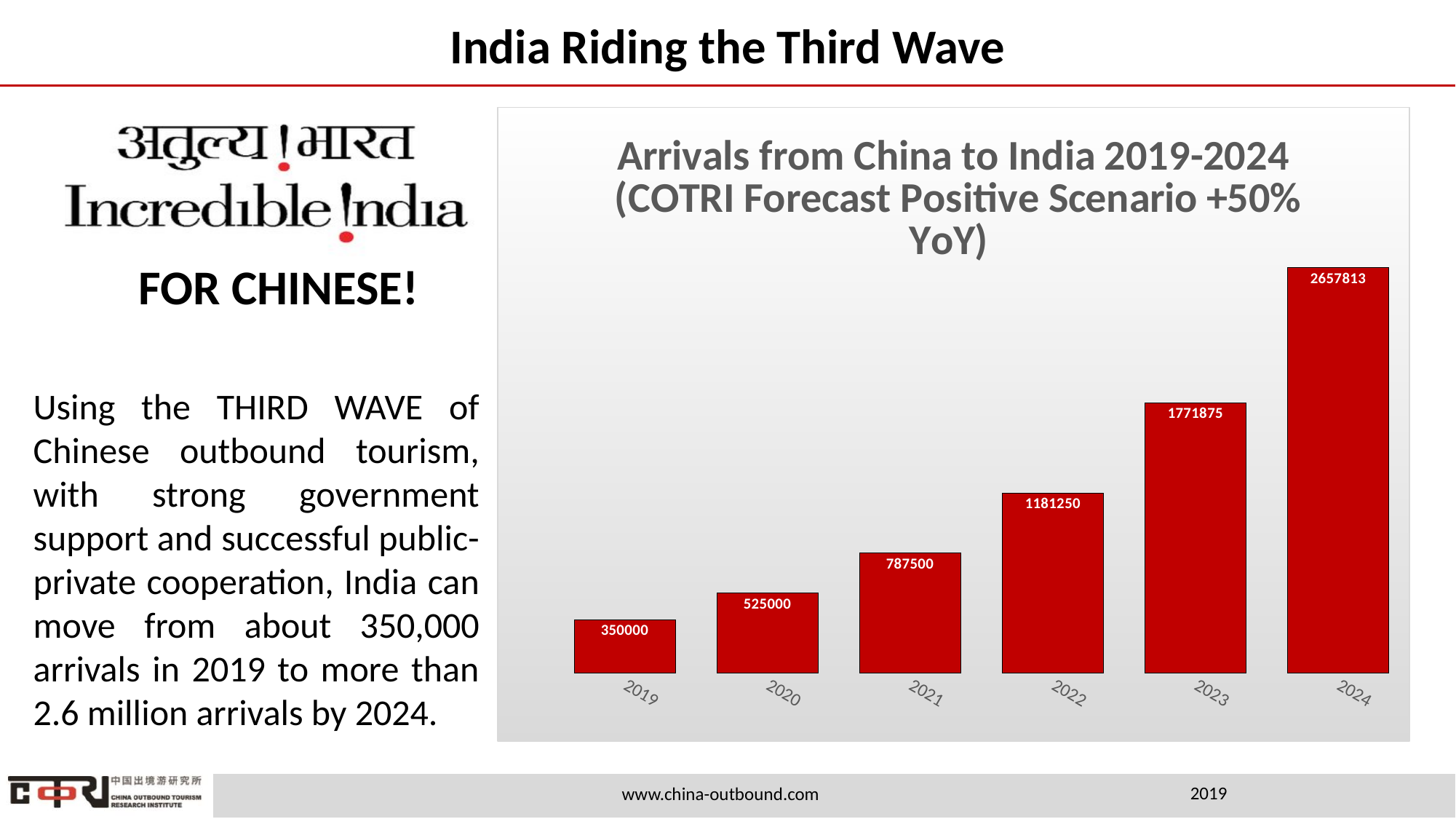
What is the difference between the values for 2020 and 2019? 175000 Which is larger, the value for 2022 or the value for 2021? 2022 Which year has the highest value in the chart? 2024 Do the values rise or fall from 2019 to 2024? Rise Which year has the lowest value in the chart? 2019 What is the difference between the values for 2024 and 2023? 885938 How many years are shown in the chart? 6 What kind of chart is shown on the slide? Bar chart What is the value for 2023 in the chart? 1771875 What is the title of the chart? Arrivals from China to India 2019-2024 (COTRI Forecast Positive Scenario +50% YoY) What is the value for 2021 in the chart? 787500 What is the value for 2019 in the chart? 350000